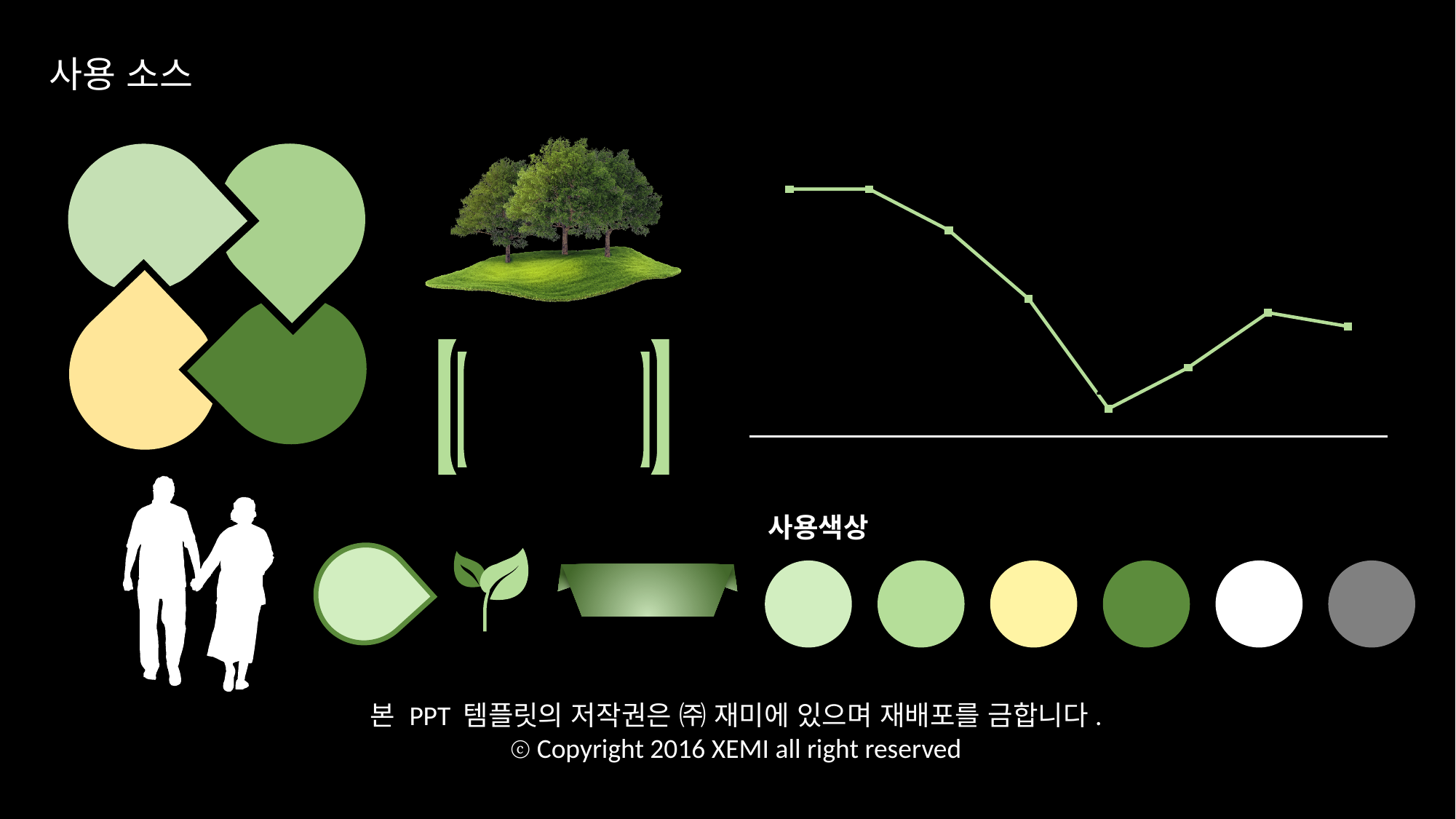
What colour is the line on the line chart? light green Which point on the line chart is the lowest: the sixth or the eighth? the sixth Does the line chart display a legend? No How many data points are plotted on the line chart? 8 On the line chart, is the last point higher or lower than the first point? lower On the line chart, does the line rise or fall between the sixth and seventh points? rise On the line chart, does the line rise or fall between the second and sixth points? fall How many lines (series) are plotted on the line chart? 1 What kind of chart is shown on the right side of the slide? line chart